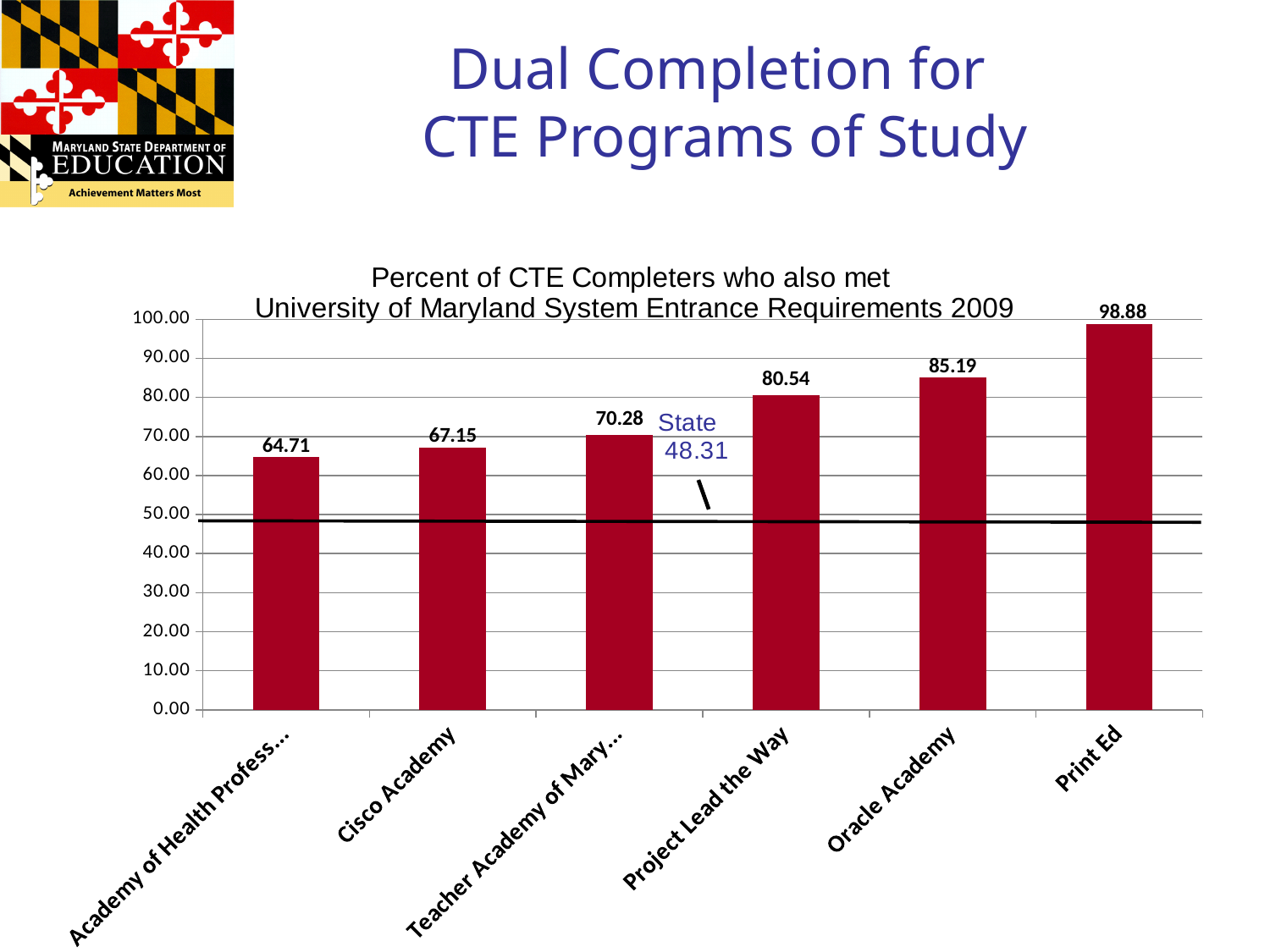
What is the difference between the values for Print Ed and Oracle Academy? 13.69 Which is larger, the value for Oracle Academy or the value for Project Lead the Way? Oracle Academy What is the value for Print Ed? 98.88 What is the value for Cisco Academy? 67.15 Which program has the highest value? Print Ed Which program has the lowest value? Academy of Health Profess... What is the difference between the values for Project Lead the Way and Cisco Academy? 13.39 What is the value for Project Lead the Way? 80.54 How many programs are shown as bars in the chart? 6 What is the value for Oracle Academy? 85.19 What value is marked by the horizontal 'State' line on the chart? 48.31 What kind of chart is shown on the slide? Bar chart